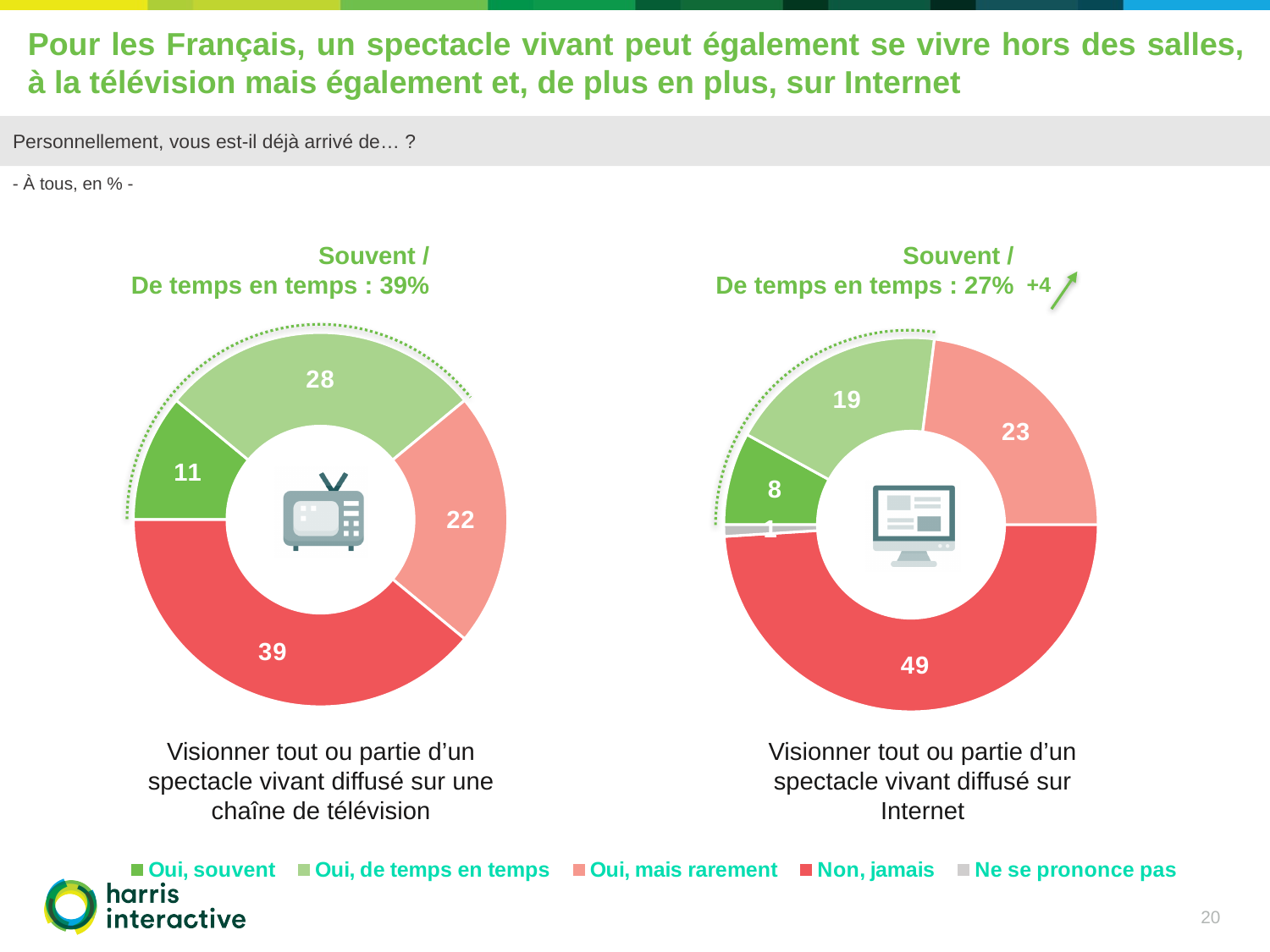
In the Internet chart (right), what is the value for "Oui, souvent"? 8 In the television chart (left), which category has the largest slice? Non, jamais What change is indicated next to the "Souvent / De temps en temps" figure for the Internet chart (right)? +4 In the television chart (left), what is the value for "Non, jamais"? 39 In the television chart (left), which category has the smallest slice? Oui, souvent In the Internet chart (right), what is the value for "Oui, de temps en temps"? 19 What kind of chart is used on this slide? Donut (pie) chart In the television chart (left), what is the combined value of "Oui, souvent" and "Oui, de temps en temps"? 39 Which is larger in the television chart (left): "Oui, de temps en temps" or "Oui, mais rarement"? Oui, de temps en temps What combined percentage of "Souvent / De temps en temps" is shown above the Internet chart (right)? 27% In the Internet chart (right), what is the difference between "Non, jamais" and "Oui, mais rarement"? 26 How many categories does the legend list? 5